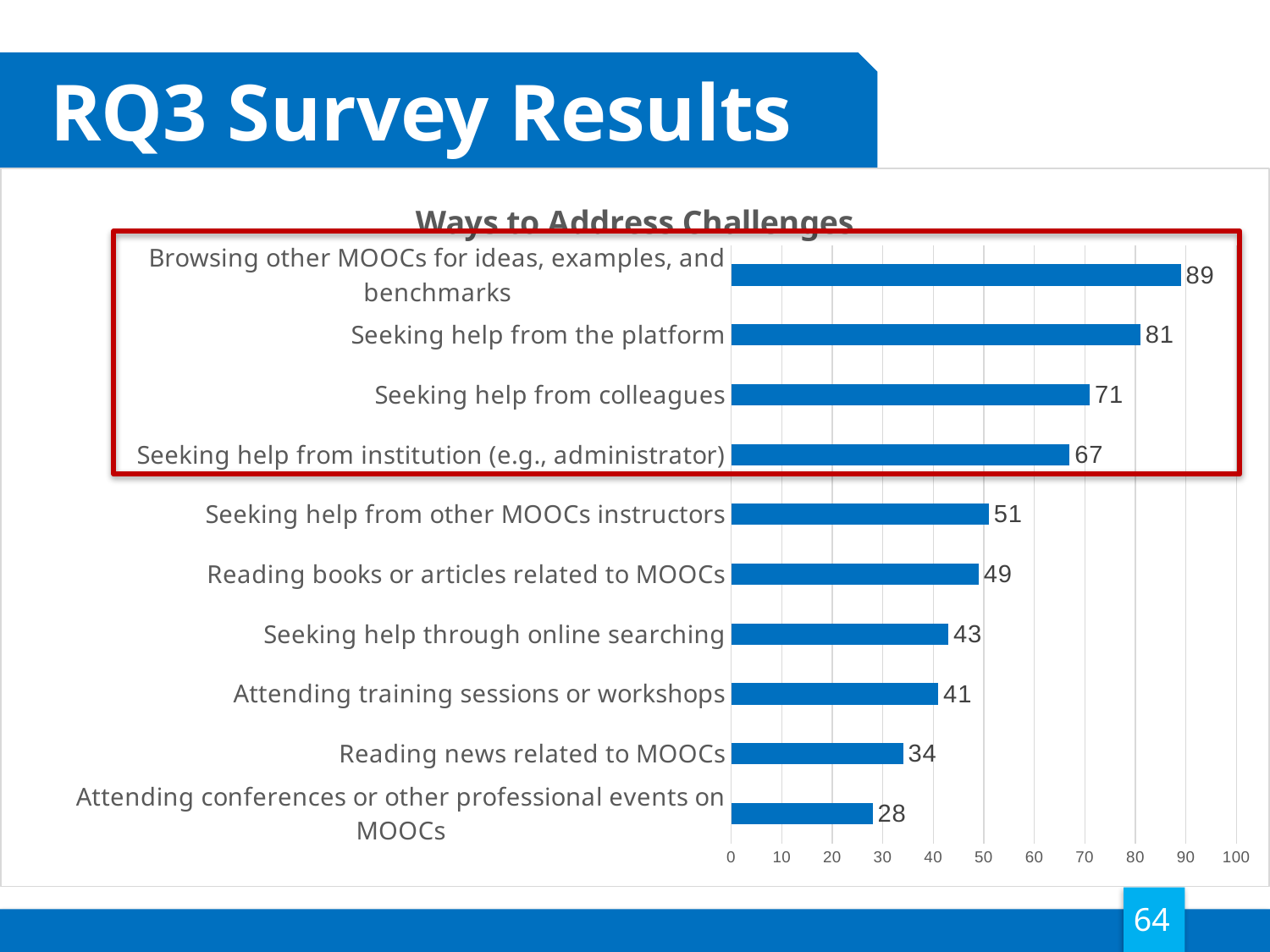
How many categories are shown in the chart? 10 What is the value for "Seeking help from the platform"? 81 What kind of chart is shown on the slide? bar chart Which category has the highest value? Browsing other MOOCs for ideas, examples, and benchmarks What is the title of the chart? Ways to Address Challenges What is the value for "Reading books or articles related to MOOCs"? 49 How many categories are enclosed by the red box on the chart? 4 Which category has the lowest value? Attending conferences or other professional events on MOOCs What is the value for "Attending conferences or other professional events on MOOCs"? 28 Which is larger: the value for "Seeking help through online searching" or "Reading news related to MOOCs"? Seeking help through online searching Is the value for "Seeking help from other MOOCs instructors" greater or less than 50? greater What is the difference between the values for "Seeking help from colleagues" and "Seeking help from institution (e.g., administrator)"? 4